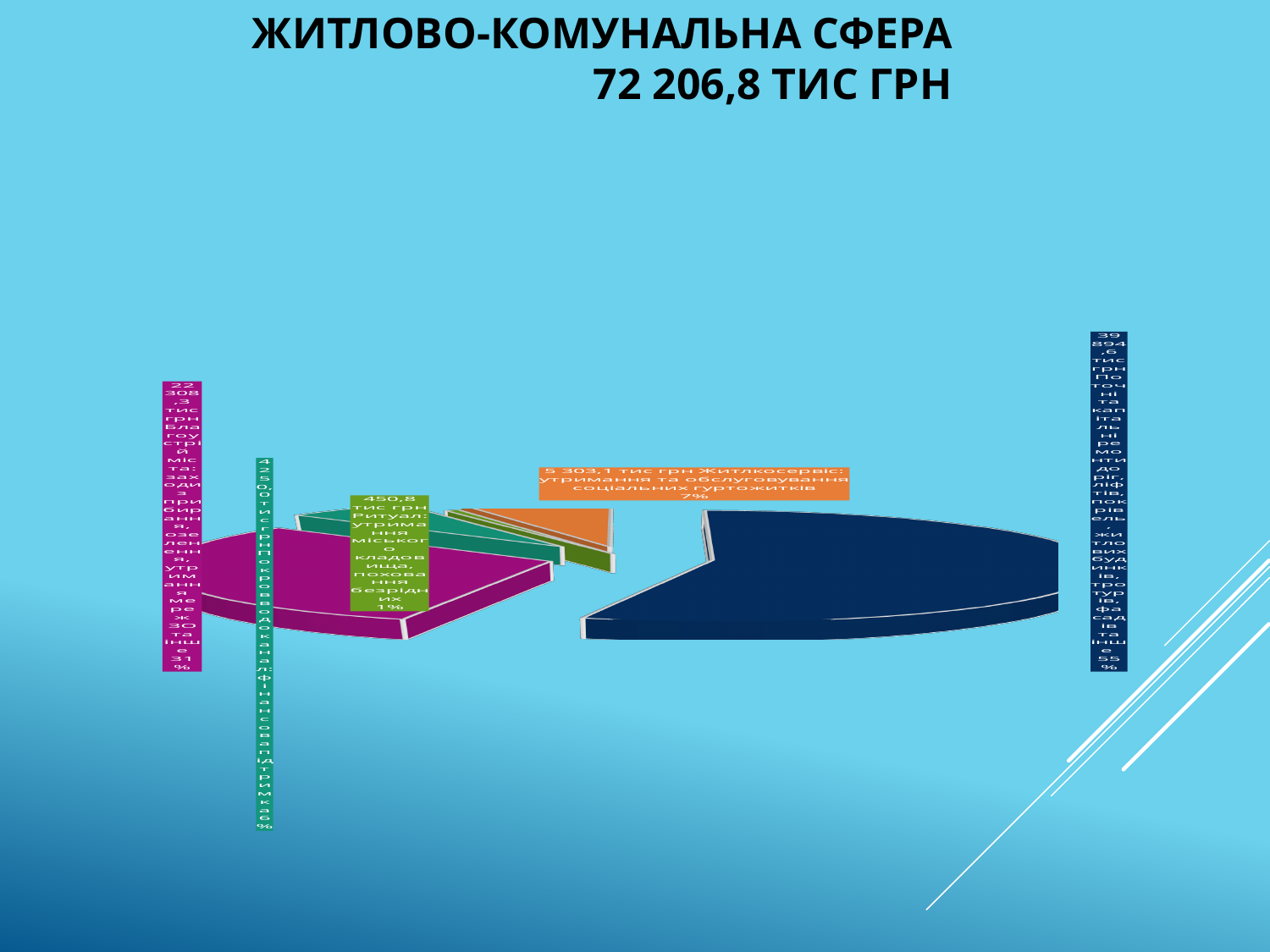
Which slice is the smallest in the pie chart? Ритуал: утримання міського кладовища, поховання безрідних What is the value for Ритуал: утримання міського кладовища, поховання безрідних? 450,8 тис грн Which slice is the largest in the pie chart? Поточні та капітальні ремонти доріг, ліфтів, покрівель, житлових будинків, тротуарів, фасадів та інше What is the value for Покровводоканал: фінансова підтримка? 4 250,0 тис грн What colour is the slice for Благоустрій міста? magenta What share of the pie does the slice for Поточні та капітальні ремонти доріг, ліфтів, покрівель, житлових будинків, тротуарів, фасадів та інше represent? 55% What share of the pie does the Благоустрій міста slice represent? 31% How many slices does the pie chart have? 5 What kind of chart is shown on the slide? pie chart Which is larger: the value for Житлкосервіс or the value for Покровводоканал? Житлкосервіс What is the value for Житлкосервіс: утримання та обслуговування соціальних гуртожитків? 5 303,1 тис грн What is the total amount shown in the chart title? 72 206,8 тис грн